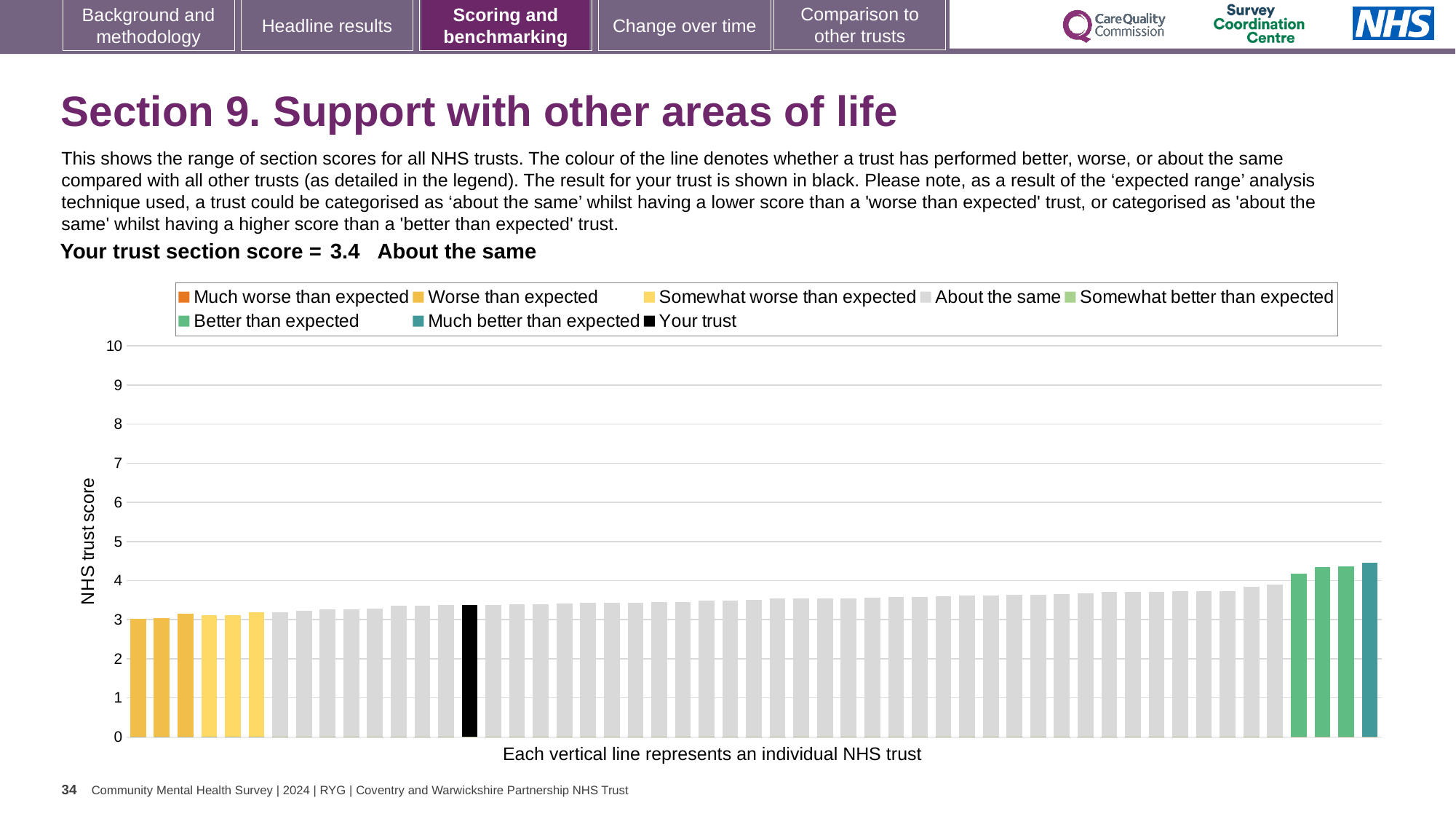
Which is larger, the leftmost bar or the rightmost bar? the rightmost bar Is the value of the tallest bar in the chart greater or less than 4? greater Do the bar values rise or fall from left to right along the x axis? rise What kind of chart is shown on the slide? bar chart How many entries does the chart legend list? 8 Which performance category is your trust placed in according to the slide? About the same Is the value of the black 'Your trust' bar greater or less than 5? less Which legend category does the tallest bar in the chart belong to? Much better than expected Is the value of the shortest bar in the chart greater or less than 4? less How many bars are coloured as 'Better than expected' (green)? 3 What is the section score for your trust shown on the slide? 3.4 What is the label on the vertical axis of the chart? NHS trust score